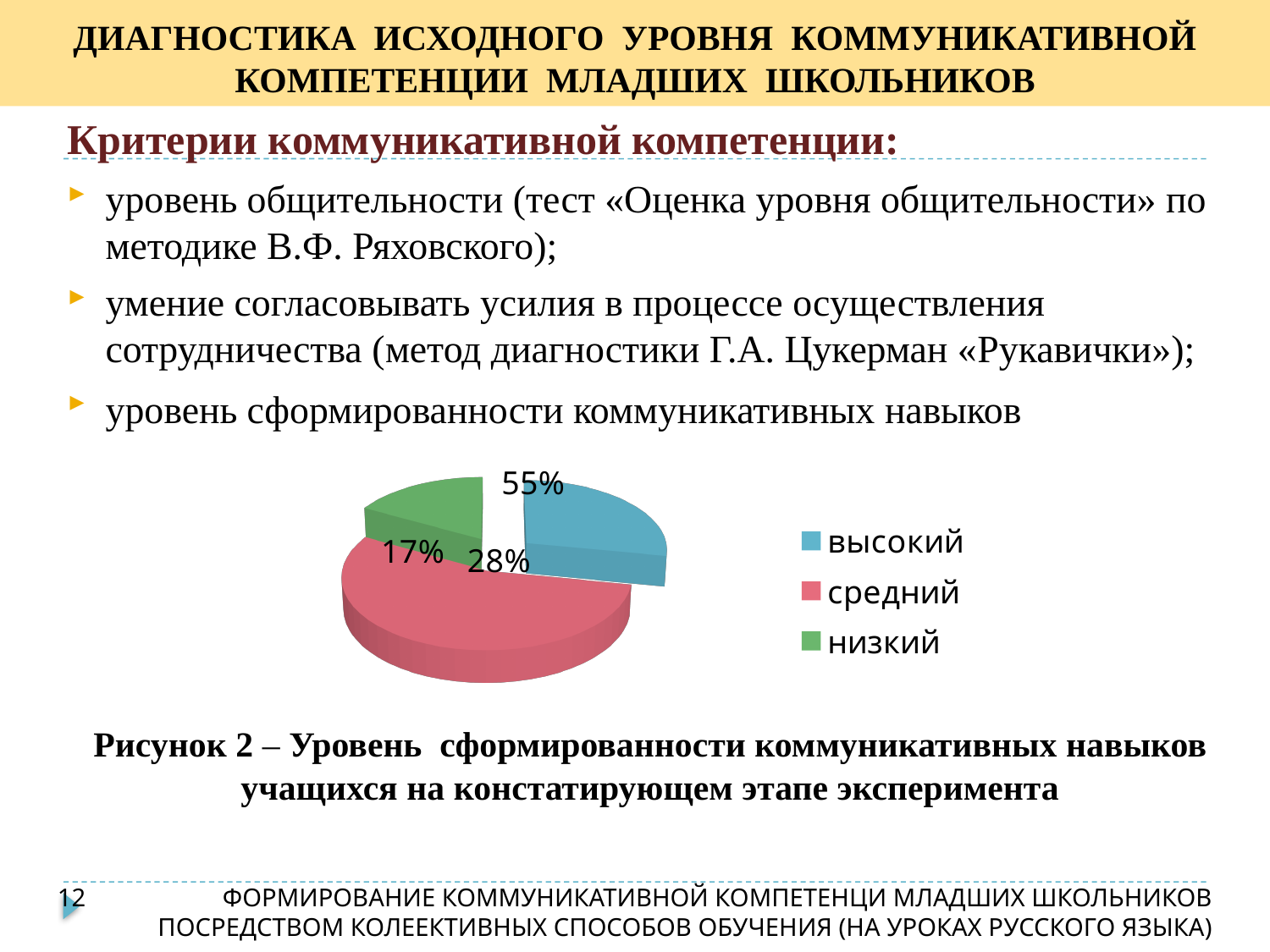
What kind of chart is shown on the slide? pie chart Which slice is larger in the pie chart, средний or высокий? средний Which category has the largest slice in the pie chart? средний Which slice is larger in the pie chart, высокий or низкий? высокий What is the smallest percentage label shown on the pie chart? 17% What colour is the низкий slice in the pie chart? green What colour is the высокий slice in the pie chart? blue What do the three percentage labels on the pie chart add up to? 100% How many slices does the pie chart have? 3 How many entries does the legend of the pie chart list? 3 Which category has the smallest slice in the pie chart? низкий What is the largest percentage label shown on the pie chart? 55%